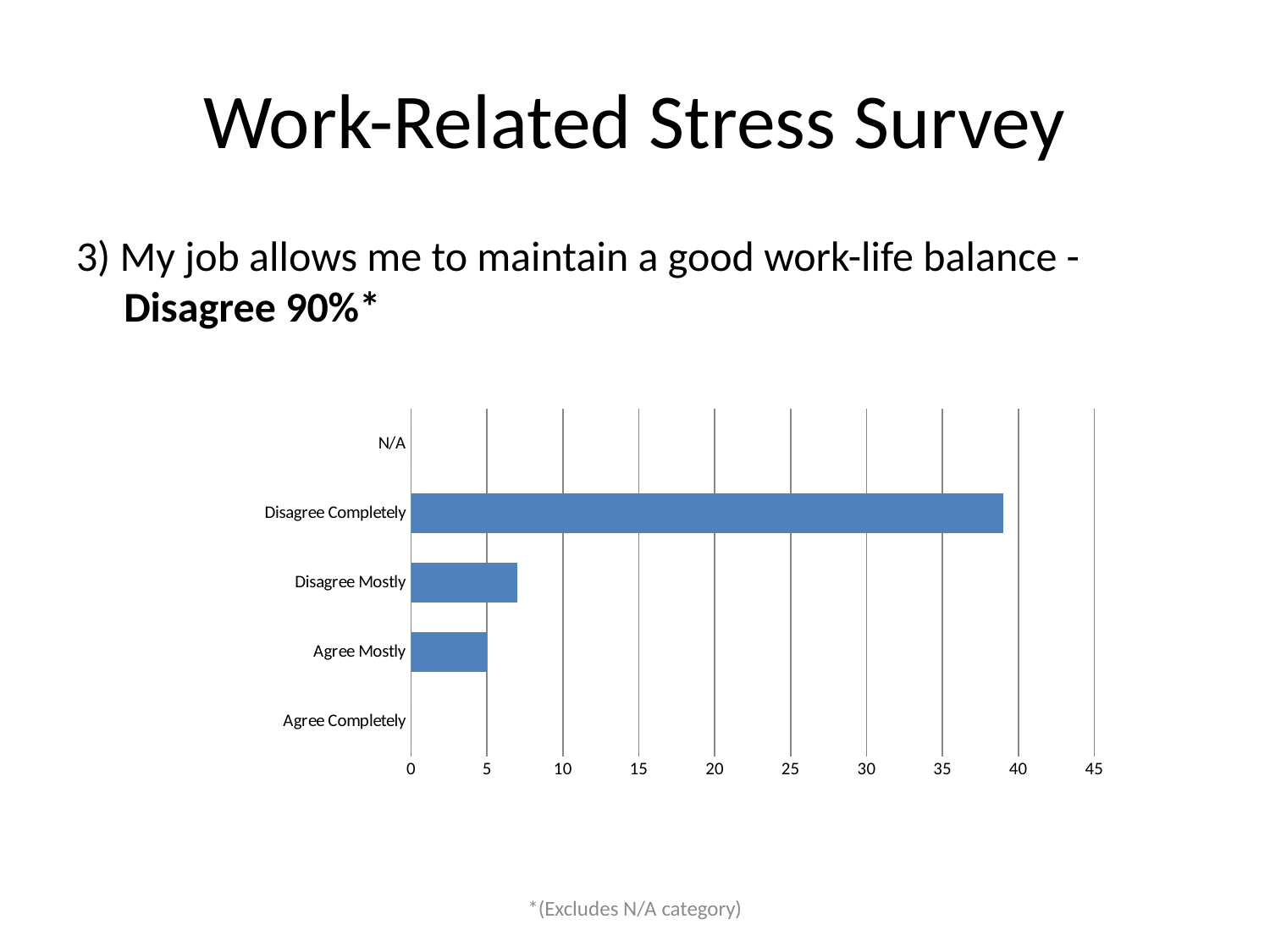
How many categories are listed on the vertical axis of the chart? 5 What is the value for Agree Mostly? 5 Which category has the highest value in the chart? Disagree Completely Which is larger, the value for Disagree Mostly or the value for Agree Mostly? Disagree Mostly Is the value for Disagree Mostly greater or less than 5? greater What is the highest tick value shown on the horizontal axis? 45 What kind of chart is shown on the slide? bar chart Is the value for Disagree Completely greater or less than 40? less According to the slide text, what percentage of respondents disagree with the statement about work-life balance? 90% Is the value for Disagree Mostly greater or less than 10? less